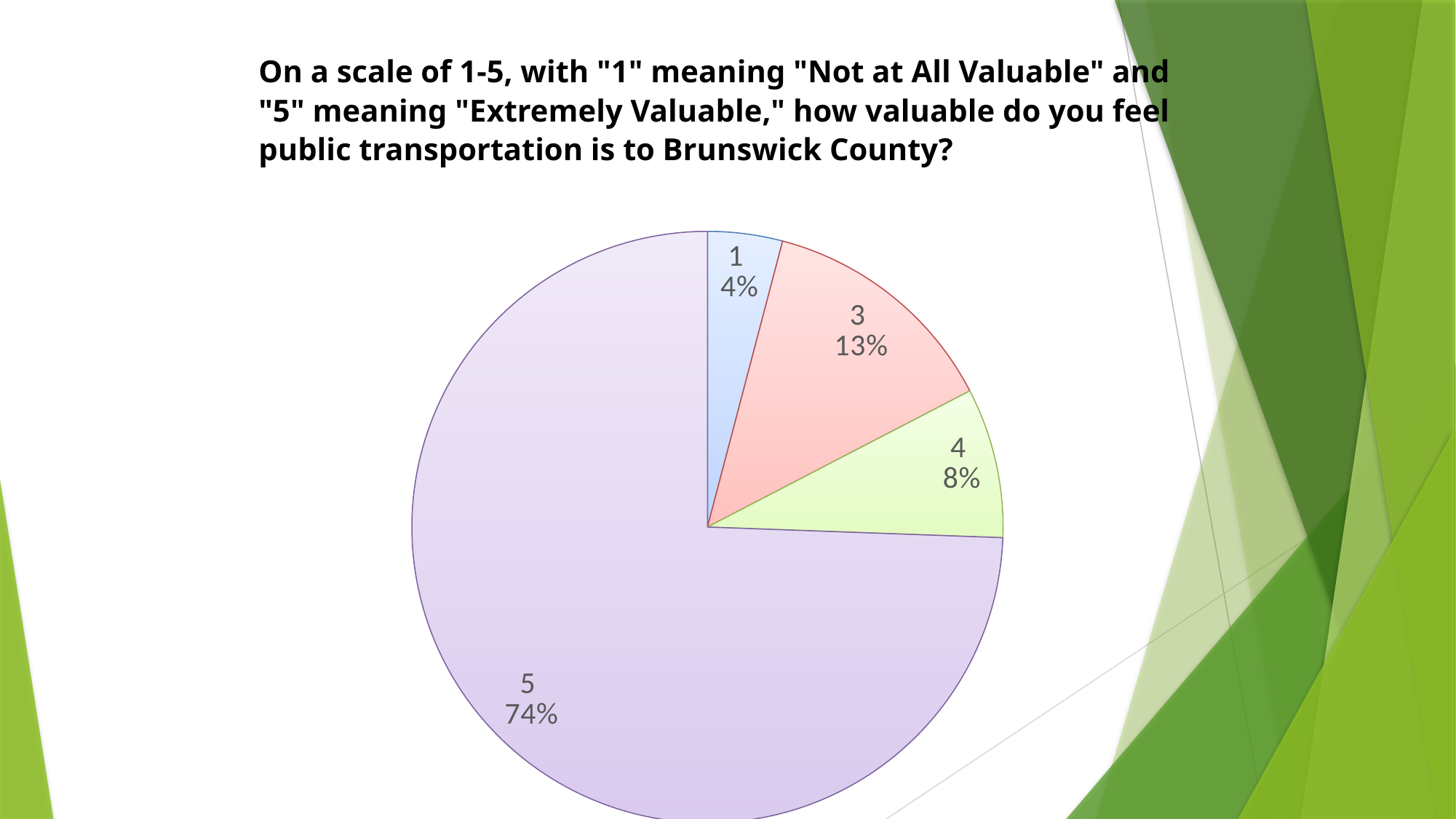
Which labeled rating has the smallest slice of the pie? 1 What share of the pie is labeled for rating 3? 13% Which slice is larger, rating 3 or rating 4? 3 How many labeled slices does the pie chart have? 4 What kind of chart is shown on the slide? pie chart What share of the pie is labeled for rating 5? 74% What is the difference in percentage points between the slices for rating 4 and rating 1? 4% What colour is the slice for rating 5? purple Which rating has the largest slice of the pie? 5 What share of the pie is labeled for rating 4? 8% What share of the pie is labeled for rating 1? 4% What is the difference in percentage points between the slices for rating 5 and rating 3? 61%